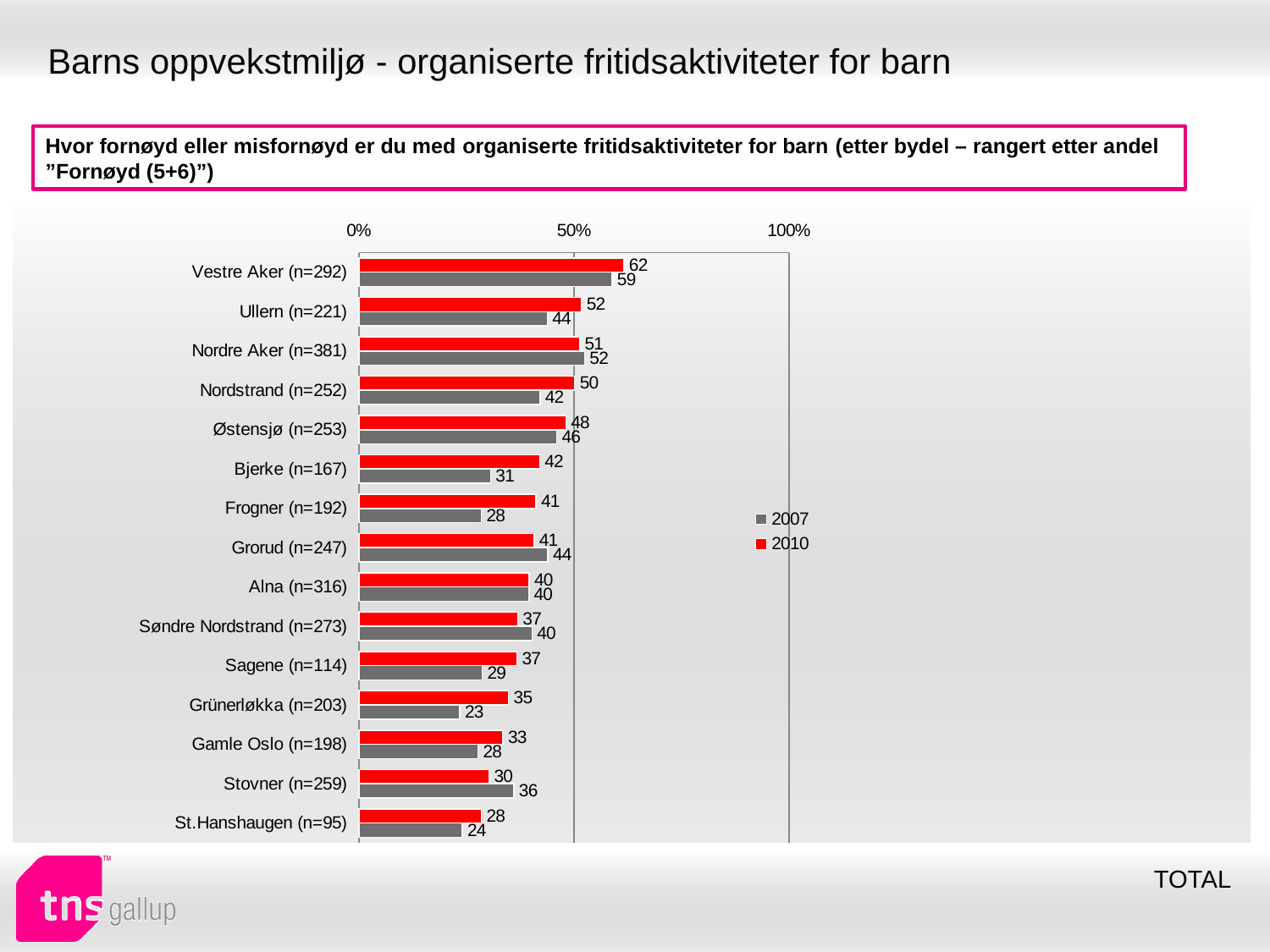
How many series does the legend list? 2 What is the 2007 value for Grünerløkka (n=203)? 23 Which bydel has the lowest 2010 value? St.Hanshaugen (n=95) What is the 2007 value for Stovner (n=259)? 36 What is the difference between the 2010 and 2007 values for Frogner (n=192)? 13 Which bydel has the highest 2010 value? Vestre Aker (n=292) Which is larger for Nordre Aker (n=381), the 2007 value or the 2010 value? 2007 Which colour represents the 2010 series in the chart? Red What is the 2010 value for Vestre Aker (n=292)? 62 What kind of chart is shown on the slide? Bar chart How many bydeler (categories) are shown in the chart? 15